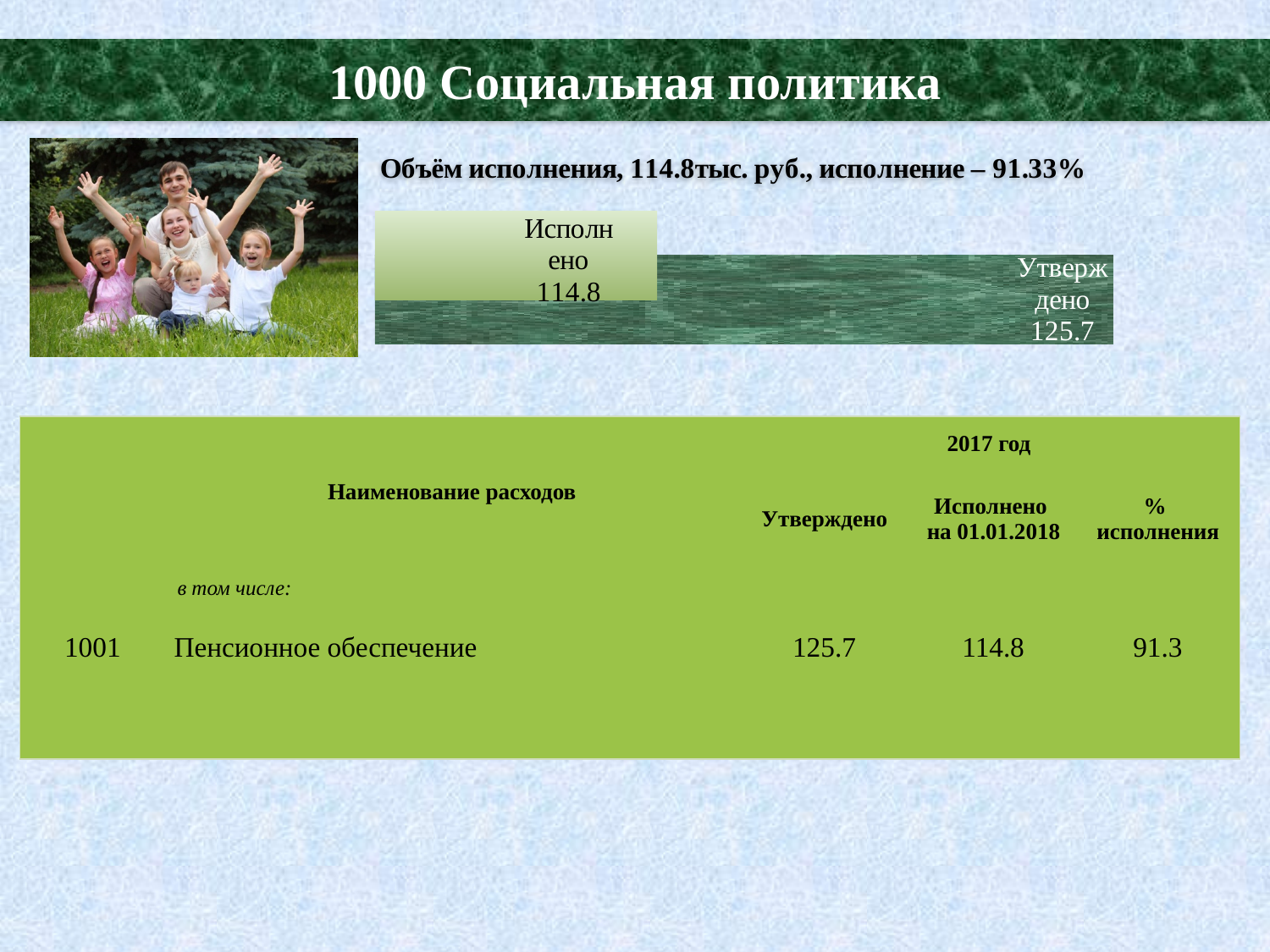
What is the value of the Утверждено bar in the chart? 125.7 Which is larger in the chart, Исполнено or Утверждено? Утверждено Which bar in the chart is the highest? Утверждено What is the difference between the Утверждено and Исполнено values in the chart? 10.9 What kind of chart is shown on the slide? bar chart What is the title of the slide containing the chart? 1000 Социальная политика How many bars does the chart show? 2 What is the value of the Исполнено bar in the chart? 114.8 Which bar in the chart is the lowest? Исполнено What percentage of execution is stated in the text above the chart? 91.33%